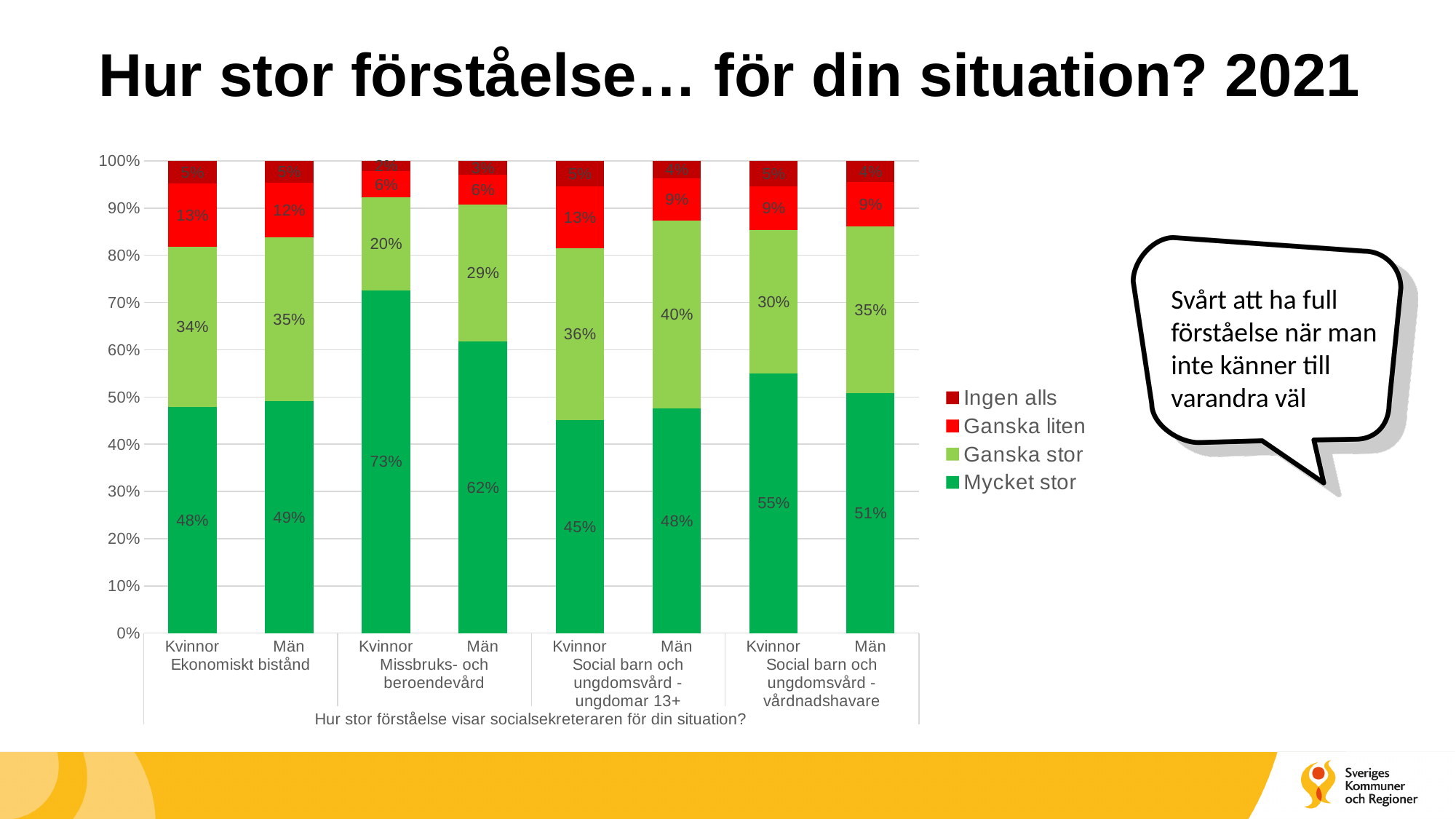
How many bars are plotted in the chart? 8 What is the 'Mycket stor' value for Kvinnor in Missbruks- och beroendevård? 73% Which legend entry is shown in dark red? Ingen alls What is the 'Ganska stor' value for Män in Social barn och ungdomsvård - ungdomar 13+? 40% What is the difference between the 'Mycket stor' values for Kvinnor and Män in Missbruks- och beroendevård? 11% Is the 'Mycket stor' value for Män in Missbruks- och beroendevård greater or less than 60%? greater What is the 'Ganska liten' value for Kvinnor in Ekonomiskt bistånd? 13% Which bar has the highest 'Mycket stor' value? Kvinnor, Missbruks- och beroendevård What kind of chart is shown on the slide? Stacked bar chart Which bar has the lowest 'Mycket stor' value? Kvinnor, Social barn och ungdomsvård - ungdomar 13+ How many series does the legend list? 4 Which is larger: the 'Mycket stor' value for Kvinnor or for Män in Social barn och ungdomsvård - vårdnadshavare? Kvinnor